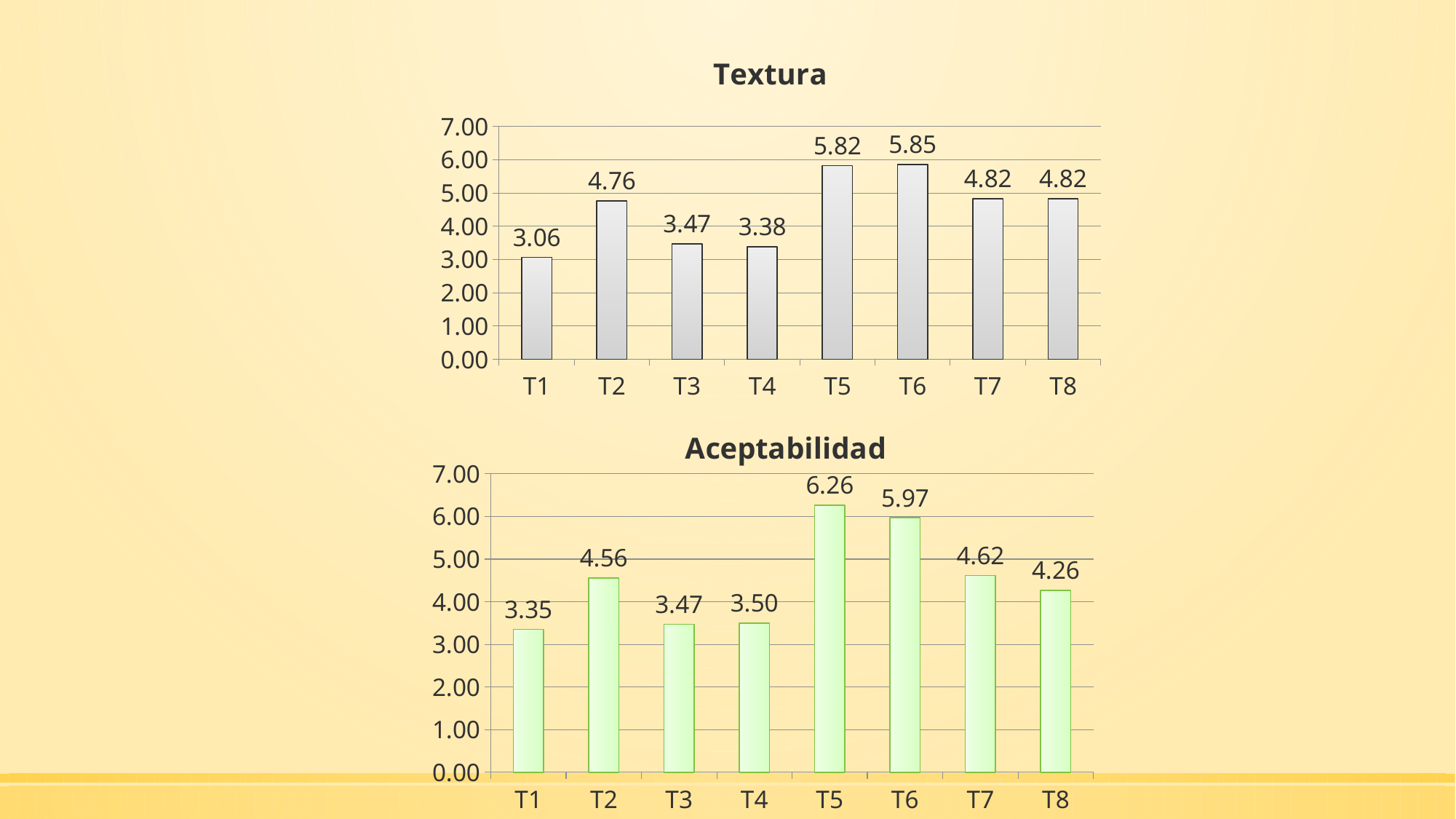
What kind of chart is the Aceptabilidad chart? Bar chart In the Aceptabilidad chart, which category has the highest value? T5 In the Textura chart, which category has the lowest value? T1 How many categories are shown in the Textura chart? 8 In the Aceptabilidad chart, which category has the lowest value? T1 In the Aceptabilidad chart, what is the difference between the values for T5 and T8? 2.00 In the Textura chart, what is the difference between the values for T6 and T1? 2.79 In the Aceptabilidad chart, which is larger, the value for T7 or the value for T8? T7 In the Aceptabilidad chart, what is the value for T2? 4.56 In the Textura chart, what is the value for T5? 5.82 In the Textura chart, which is larger, the value for T2 or the value for T3? T2 What is the title of the top chart on the slide? Textura